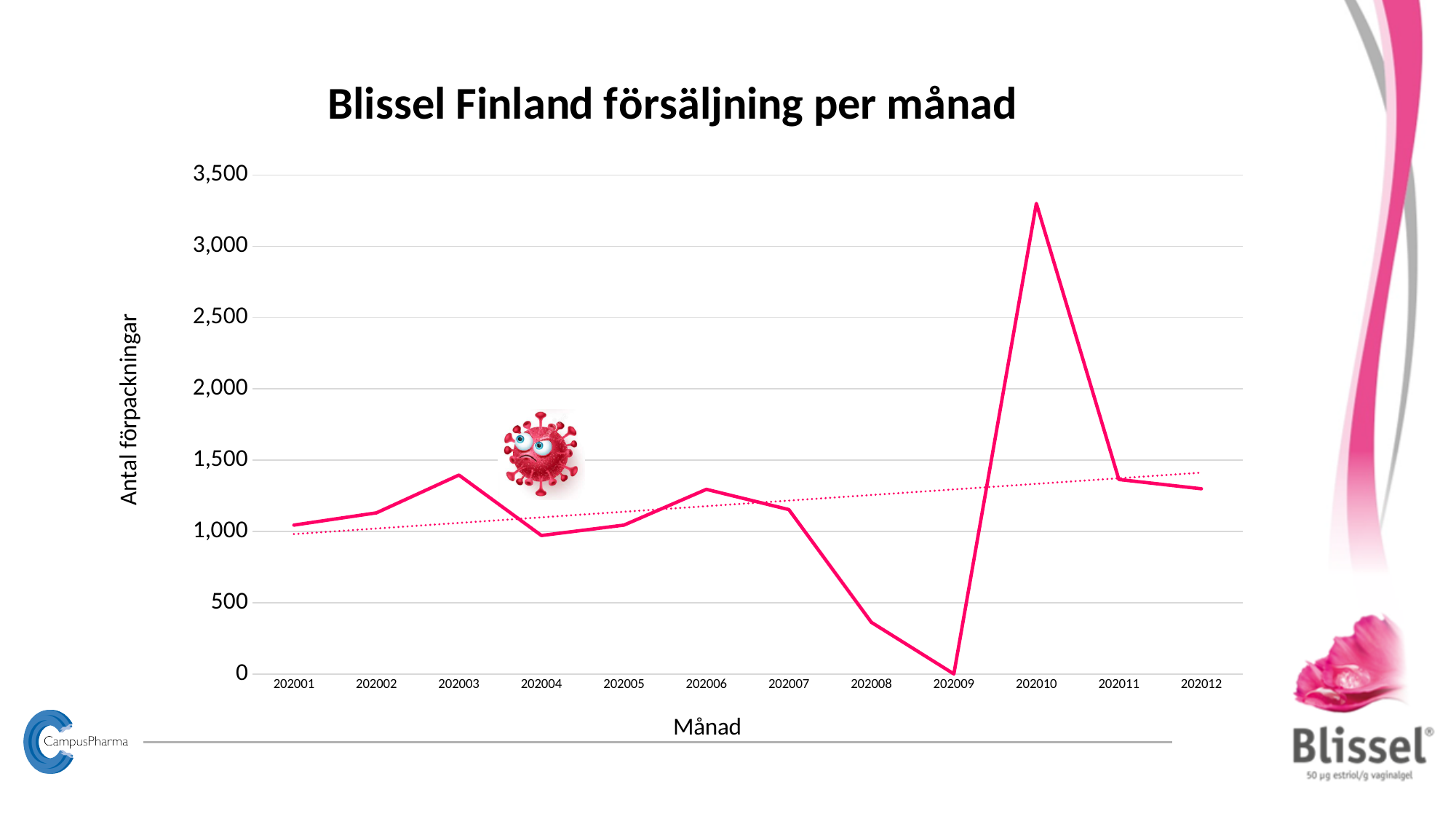
How many months are plotted on the x axis? 12 What is the title of the chart? Blissel Finland försäljning per månad Which month has the highest value? 202010 Do the values rise or fall from 202006 to 202009? fall What is the label of the y axis? Antal förpackningar Is the value for 202010 greater or less than 3,000? greater Is the value for 202003 greater or less than 1,000? greater Which month has the lowest value? 202009 What kind of chart is shown on the slide? Line chart Is the value for 202008 greater or less than 500? less Which is larger, the value for 202010 or the value for 202011? 202010